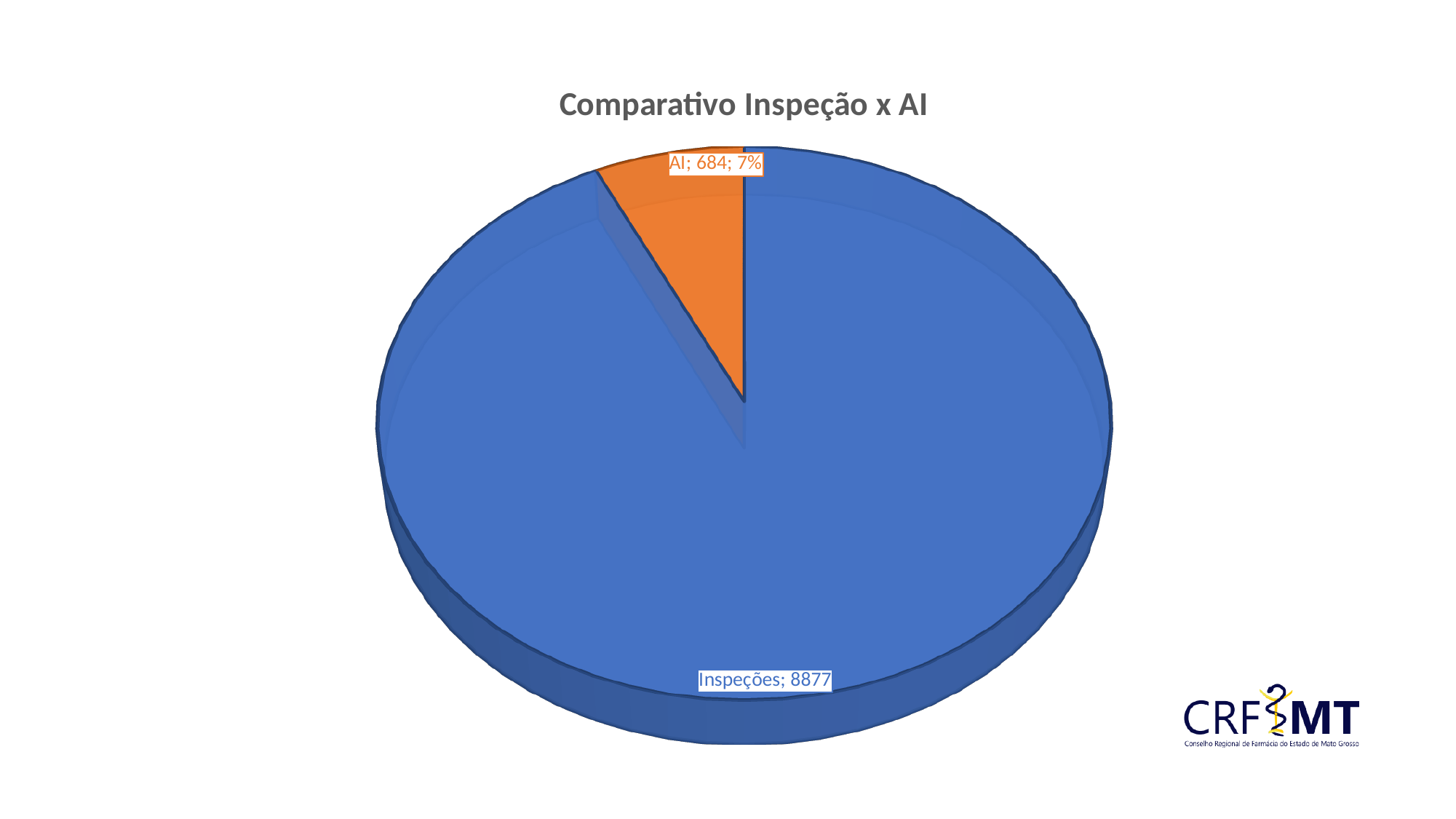
What kind of chart is shown on the slide? Pie chart What is the value for AI? 684 Which category has the largest slice? Inspeções How many categories are shown in the pie chart? 2 What colour is the AI slice? Orange Which category has the smallest slice? AI What is the total of the two values shown in the pie chart? 9561 What is the title of the chart? Comparativo Inspeção x AI What is the value for Inspeções? 8877 What percentage share does the AI slice have? 7% What is the difference between the Inspeções value and the AI value? 8193 Which is larger, Inspeções or AI? Inspeções